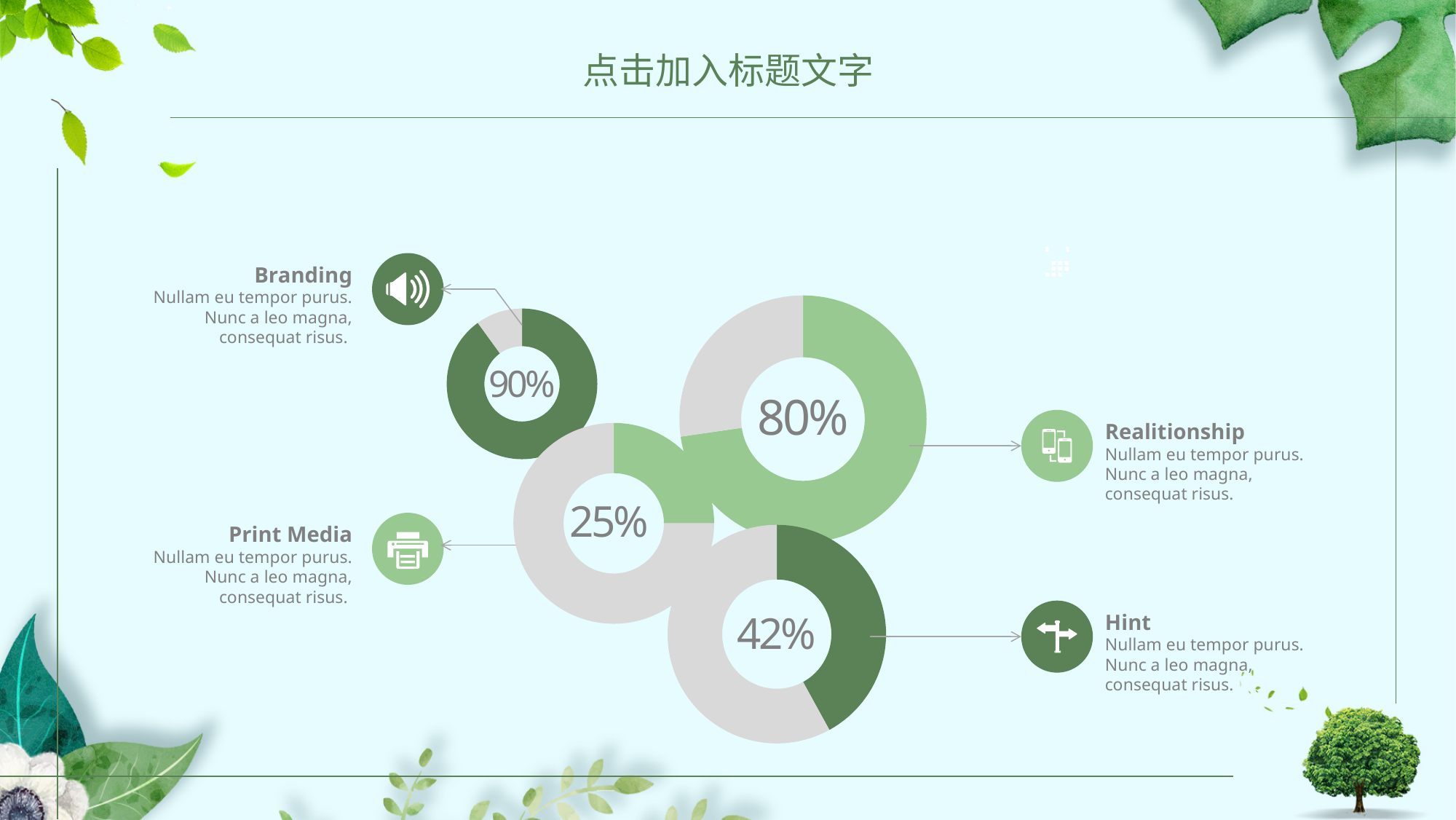
Which labelled item is linked to the donut chart showing 42%? Hint What percentage is shown in the Print Media donut chart? 25% Which of the four donut charts shows the highest percentage? Branding What is the difference between the Branding percentage and the Print Media percentage? 65% What percentage is shown in the Branding donut chart? 90% Which is larger, the Hint percentage or the Print Media percentage? Hint What is the difference between the Realitionship percentage and the Hint percentage? 38% What percentage is shown in the Realitionship donut chart? 80% How many donut charts are shown on the slide? 4 What kind of chart is used to display the percentages on the slide? Donut chart Which of the four donut charts shows the lowest percentage? Print Media What percentage is shown in the Hint donut chart? 42%